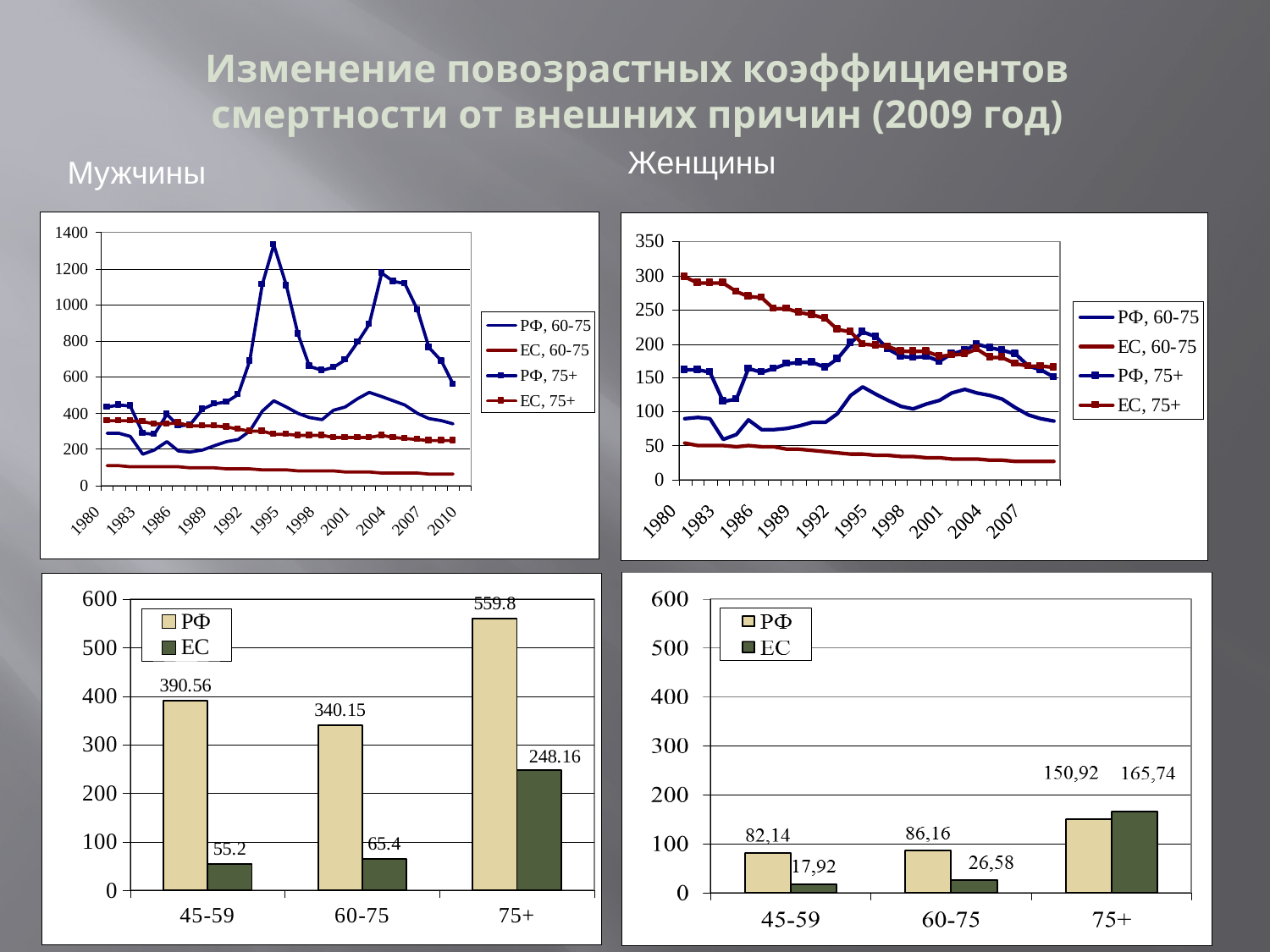
In the top-left line chart (men), is the value for РФ, 75+ in 1995 greater or less than 1200? greater How many age groups are shown on the x axis of the bottom-left bar chart (men)? 3 How many series does the legend of the top-left line chart (men) list? 4 In the bottom-left bar chart (men), what is the value for РФ in the 75+ age group? 559.8 In the bottom-left bar chart (men), what is the difference between the РФ and ЕС values for the 45-59 age group? 335.36 In the bottom-left bar chart (men), which age group has the highest РФ value? 75+ What kind of chart is the top-left chart (men)? Line chart In the bottom-right bar chart (women), which age group has the lowest ЕС value? 45-59 In the bottom-right bar chart (women), which is larger for the 75+ age group, РФ or ЕС? ЕС In the bottom-right bar chart (women), what is the value for ЕС in the 60-75 age group? 26,58 What kind of chart is the bottom-right chart (women)? Bar chart In the top-right line chart (women), does the ЕС, 75+ series rise or fall from 1980 to the end of the period? Falls